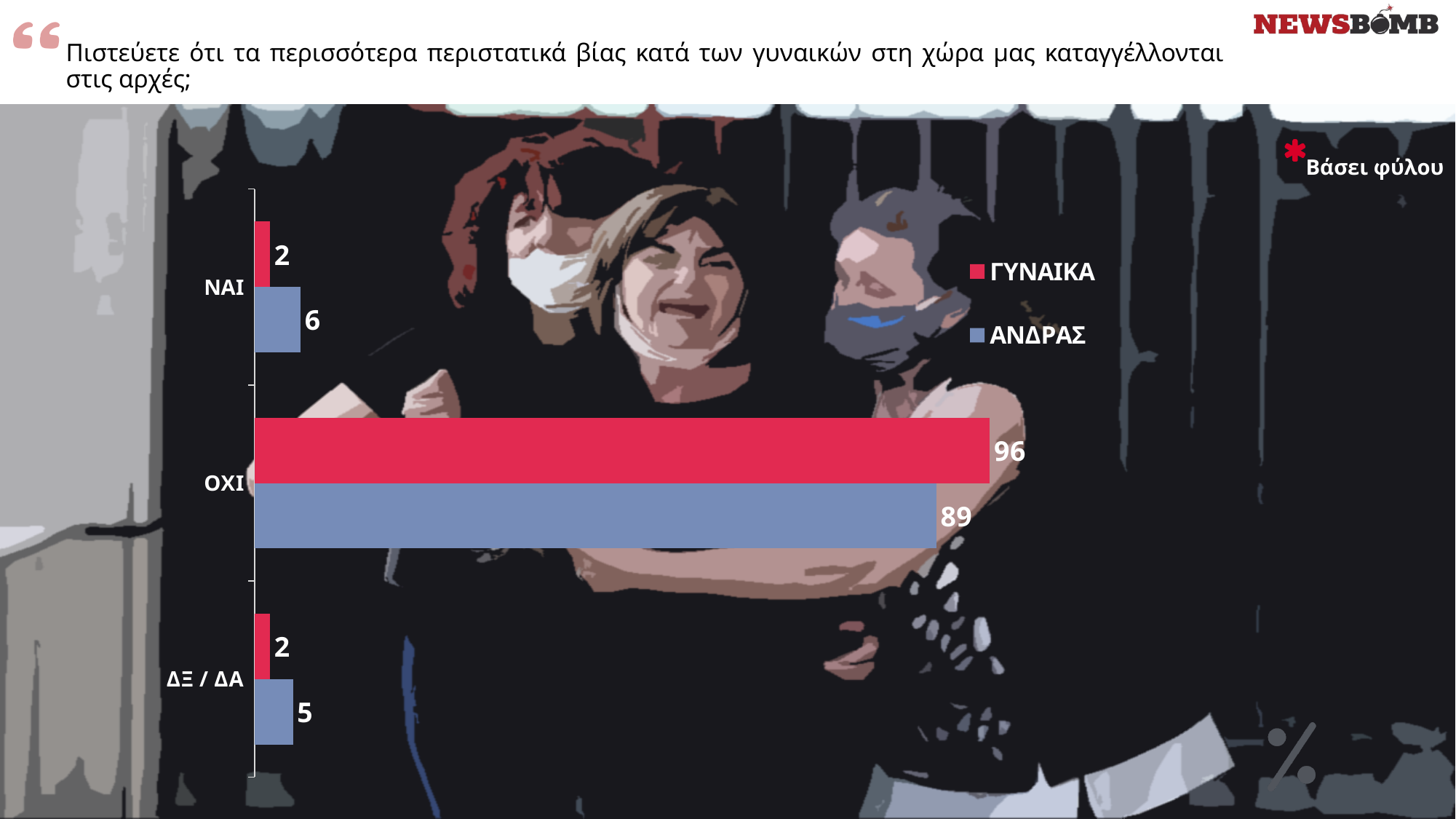
How many categories are shown on the chart? 3 How many series does the legend list? 2 What is the value for ΓΥΝΑΙΚΑ in the ΔΞ / ΔΑ category? 2 What is the value for ΑΝΔΡΑΣ in the ΟΧΙ category? 89 Which colour represents ΓΥΝΑΙΚΑ in the legend? red What is the value for ΓΥΝΑΙΚΑ in the ΟΧΙ category? 96 What is the difference between the ΑΝΔΡΑΣ values for ΝΑΙ and ΔΞ / ΔΑ? 1 What kind of chart is shown on the slide? bar chart What is the value for ΑΝΔΡΑΣ in the ΝΑΙ category? 6 What is the difference between the ΓΥΝΑΙΚΑ and ΑΝΔΡΑΣ values in the ΟΧΙ category? 7 Which category has the highest value for ΑΝΔΡΑΣ? ΟΧΙ Which is larger in the ΝΑΙ category, ΓΥΝΑΙΚΑ or ΑΝΔΡΑΣ? ΑΝΔΡΑΣ